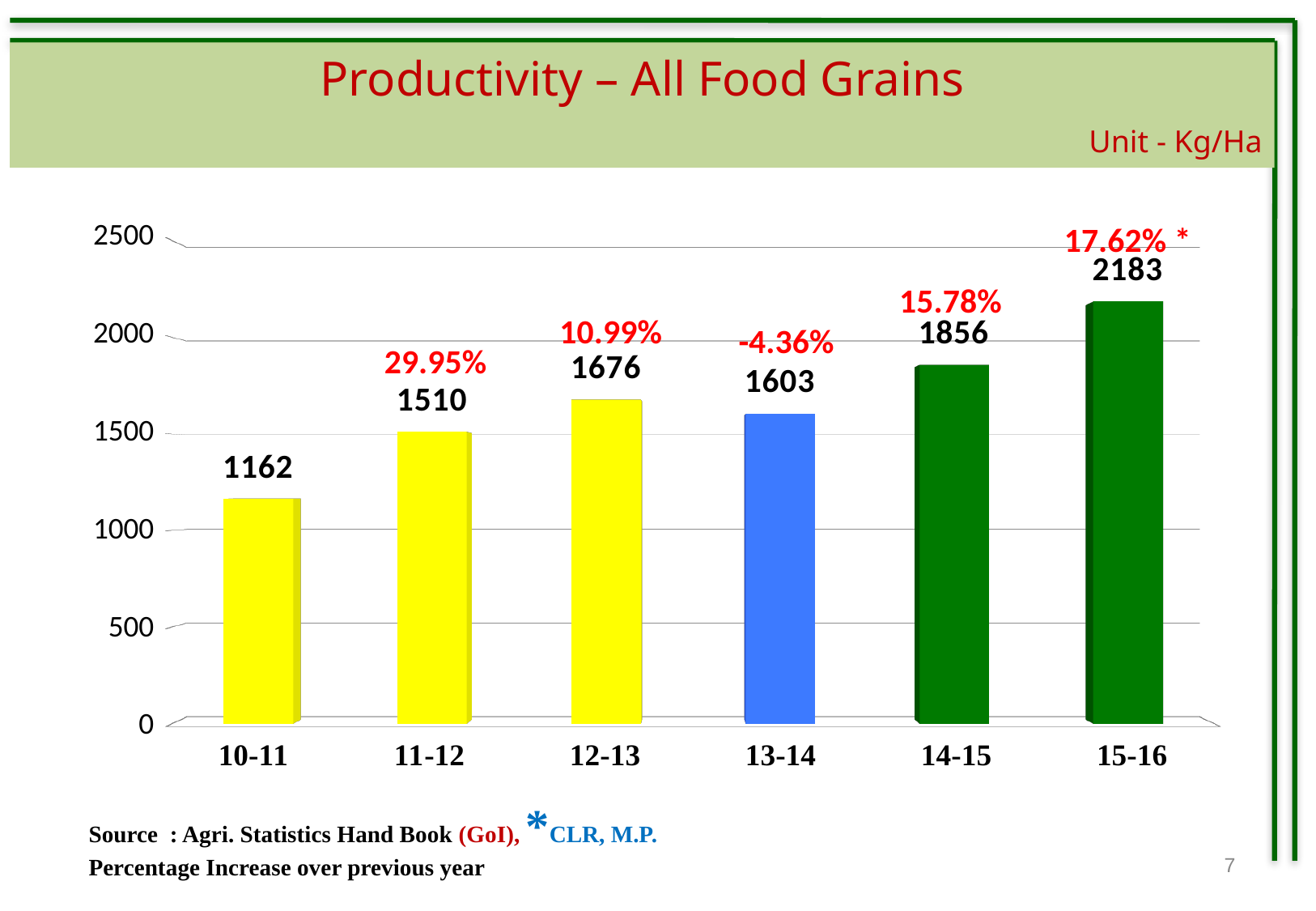
Is the value for 14-15 greater or less than 2000? less What kind of chart is shown on the slide? bar chart What percentage increase over the previous year is shown for 11-12? 29.95% What unit is stated for the chart? Kg/Ha What is the productivity value for 13-14? 1603 What is the difference in productivity between 15-16 and 14-15? 327 Which year has the highest productivity? 15-16 How many years are shown on the x axis? 6 What is the productivity value for 10-11? 1162 Which year shows a negative percentage change over the previous year? 13-14 Which year has higher productivity, 12-13 or 13-14? 12-13 Which year has the lowest productivity? 10-11